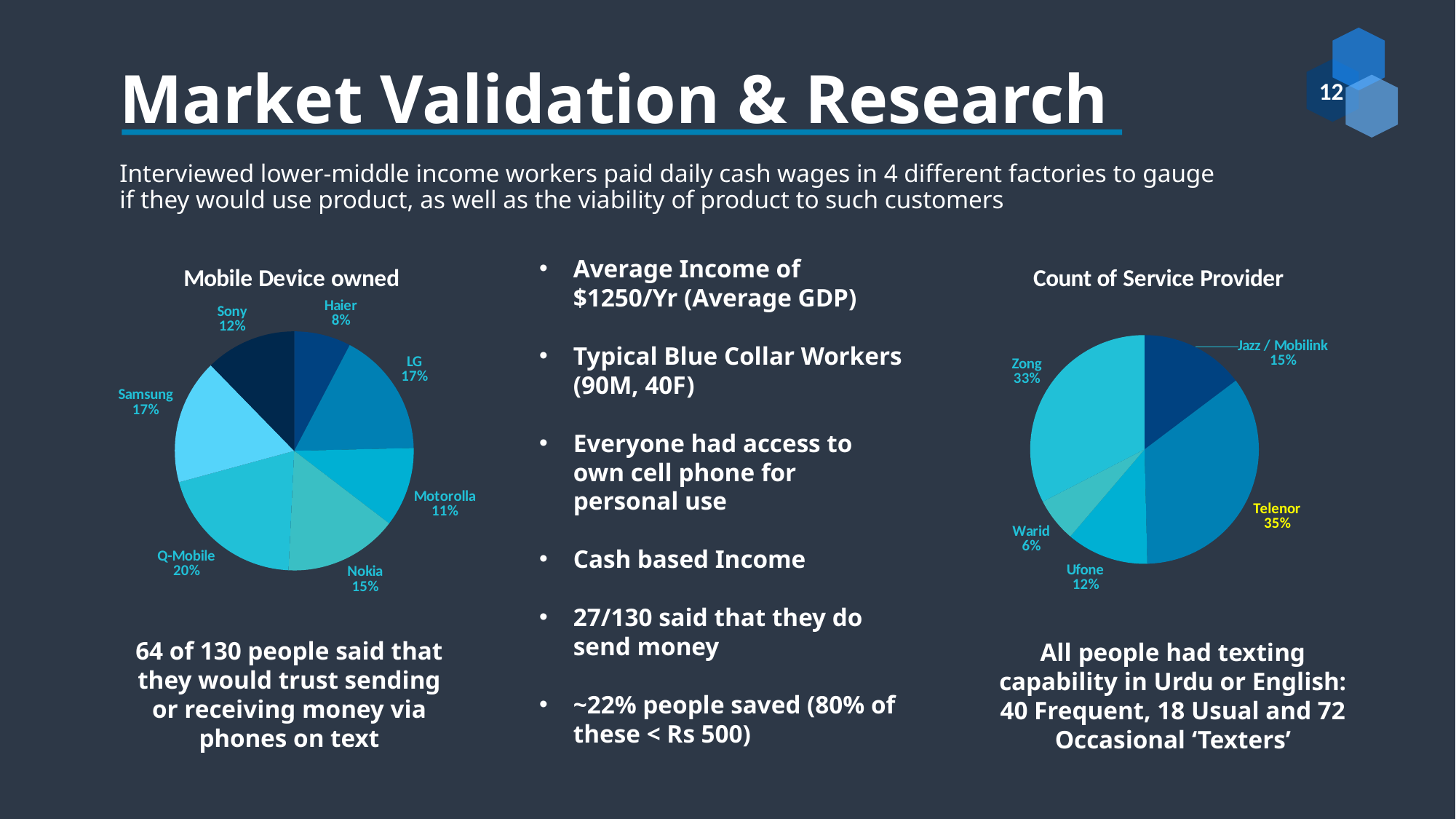
In the 'Count of Service Provider' chart, which is larger, the Jazz / Mobilink share or the Ufone share? Jazz / Mobilink In the 'Count of Service Provider' chart, how many service providers are shown? 5 In the 'Mobile Device owned' chart, what share is labelled for Q-Mobile? 20% In the 'Mobile Device owned' chart, which device brand has the largest slice? Q-Mobile What type of chart is the 'Count of Service Provider' chart? Pie chart In the 'Mobile Device owned' chart, how many device brands are shown? 7 In the 'Mobile Device owned' chart, what is the difference between the Nokia and Motorolla shares? 4% In the 'Mobile Device owned' chart, which device brand has the smallest slice? Haier In the 'Count of Service Provider' chart, what share is labelled for Telenor? 35% In the 'Mobile Device owned' chart, what share is labelled for Haier? 8% In the 'Count of Service Provider' chart, which provider has the smallest slice? Warid In the 'Count of Service Provider' chart, what share is labelled for Warid? 6%